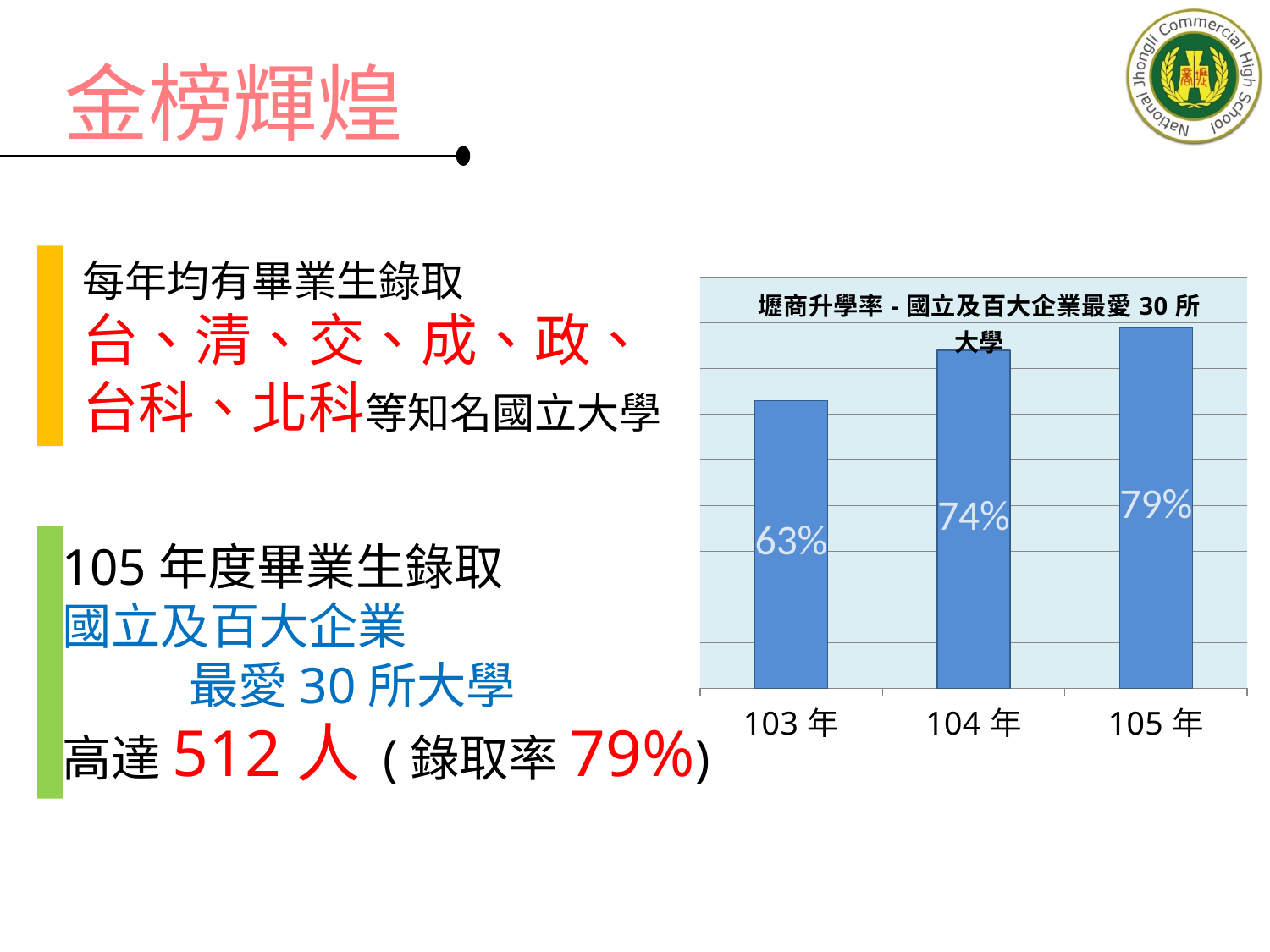
What is the value for 103 年? 63% Which year has the lowest value? 103 年 What is the value for 104 年? 74% Which is larger, the value for 104 年 or the value for 103 年? 104 年 What is the title of the chart? 壢商升學率 - 國立及百大企業最愛 30 所大學 How many years are shown on the x axis? 3 What is the value for 105 年? 79% Which year has the highest value? 105 年 What is the difference between the values for 104 年 and 103 年? 11% What is the difference between the values for 105 年 and 103 年? 16% What kind of chart is shown? bar chart Do the values rise or fall from 103 年 to 105 年? rise